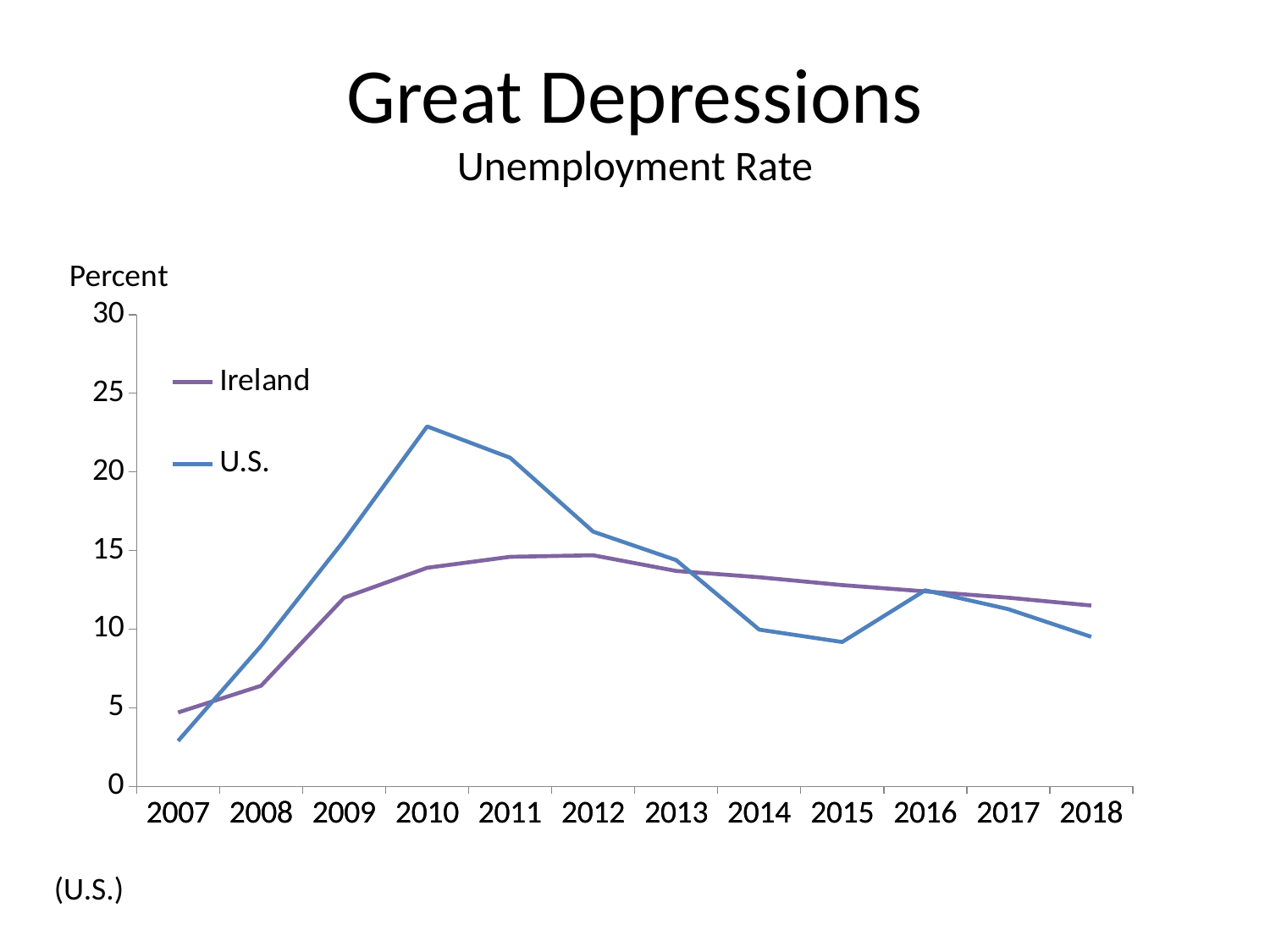
In which year is the U.S. unemployment rate at its lowest? 2007 Is the U.S. unemployment rate in 2010 greater or less than 20? greater How many years are shown on the x axis? 12 How many series does the legend list? 2 In which year does the U.S. unemployment rate reach its highest value? 2010 In 2010, which series has the higher unemployment rate, Ireland or U.S.? U.S. Is the U.S. unemployment rate in 2015 greater or less than 10? less Is the Ireland unemployment rate in 2009 greater or less than 10? greater In 2015, which series has the higher unemployment rate, Ireland or U.S.? Ireland Does the Ireland unemployment rate rise or fall from 2012 to 2018? fall What is the label on the vertical axis of the chart? Percent What kind of chart is shown on the slide? line chart